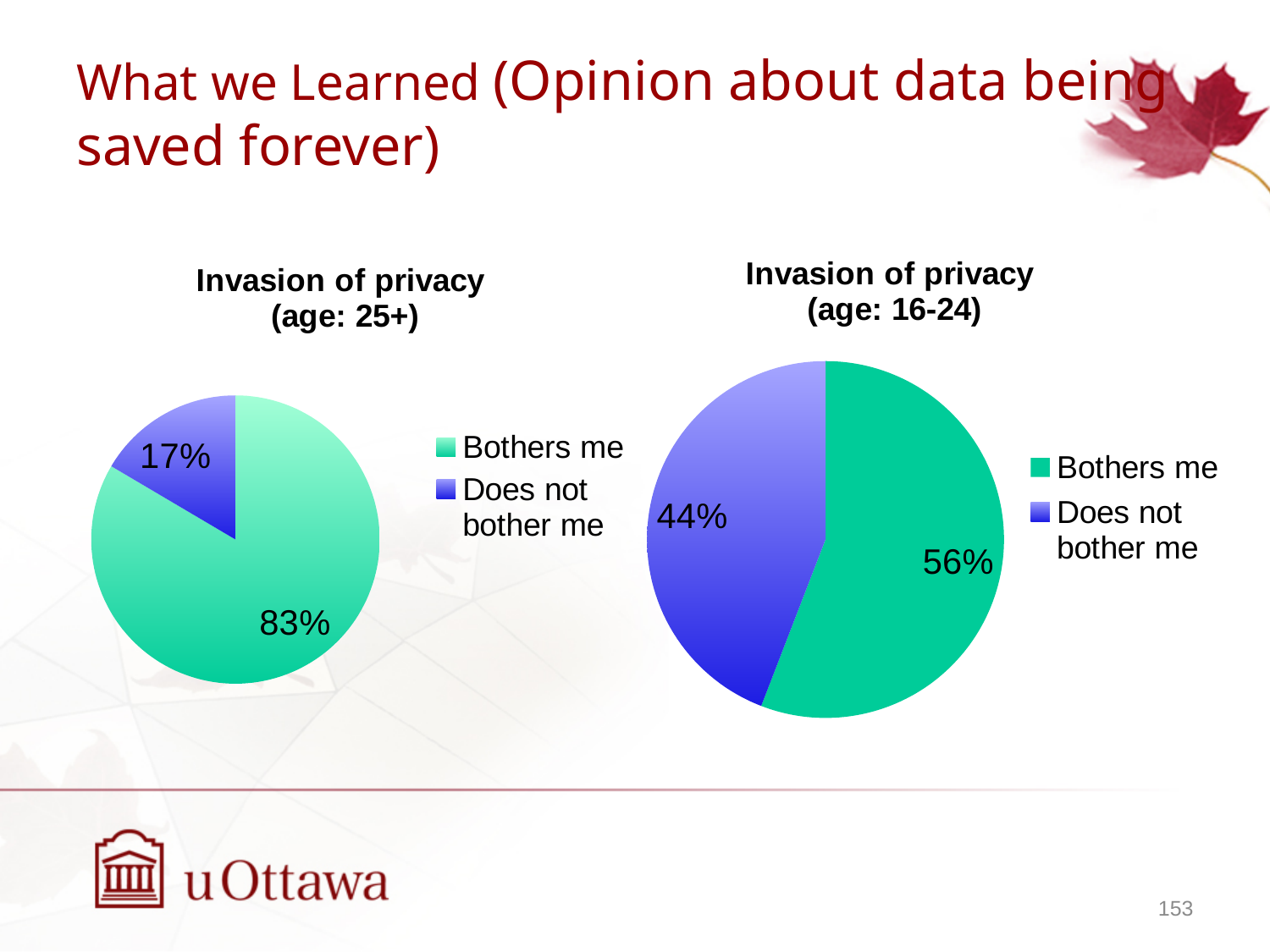
In the 'Invasion of privacy (age: 25+)' pie chart, what share of respondents said 'Bothers me'? 83% In the 'Invasion of privacy (age: 16-24)' pie chart, which slice is the smallest? Does not bother me How many slices does the 'Invasion of privacy (age: 25+)' pie chart have? 2 In the 'Invasion of privacy (age: 16-24)' pie chart, what share of respondents said 'Does not bother me'? 44% Which chart has the larger 'Bothers me' share, the age 25+ chart or the age 16-24 chart? Invasion of privacy (age: 25+) In the 'Invasion of privacy (age: 16-24)' pie chart, what share of respondents said 'Bothers me'? 56% What type of chart is the 'Invasion of privacy (age: 16-24)' chart? Pie chart In the 'Invasion of privacy (age: 16-24)' pie chart, what is the difference between the 'Bothers me' and 'Does not bother me' shares? 12% In the 'Invasion of privacy (age: 25+)' pie chart, what is the difference between the 'Bothers me' and 'Does not bother me' shares? 66% How many entries does the legend of the 'Invasion of privacy (age: 16-24)' chart list? 2 In the 'Invasion of privacy (age: 25+)' pie chart, which slice is the largest? Bothers me